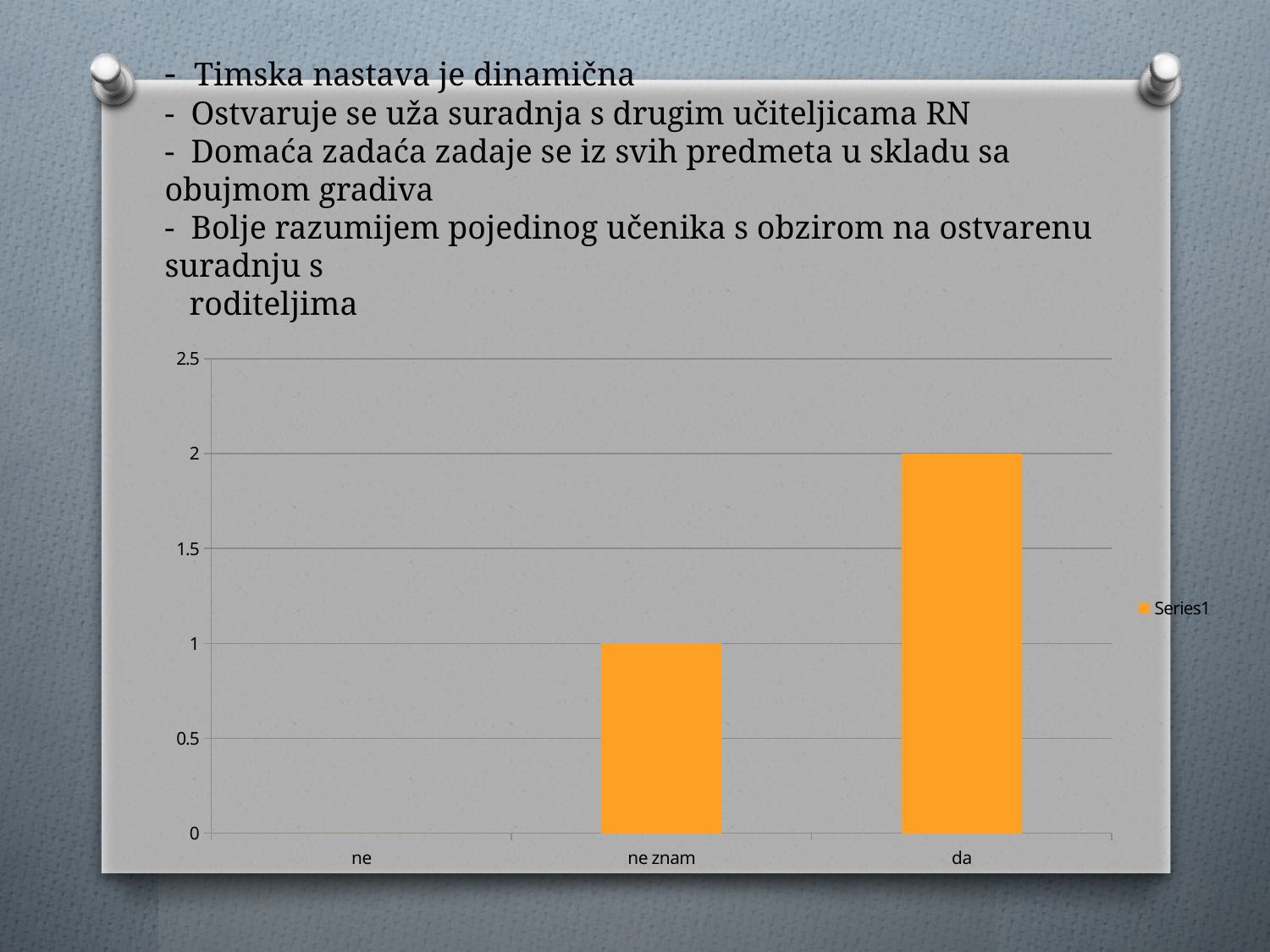
What is the value for "ne znam" in the chart? 1 Which is larger, the value for "da" or the value for "ne znam"? da What kind of chart is shown on the slide? bar chart Which category has the highest value in the chart? da How many categories are shown on the x axis of the chart? 3 What is the value for "da" in the chart? 2 Do the values rise or fall from left to right along the x axis? rise What is the value for "ne" in the chart? 0 What is the difference between the values for "da" and "ne znam"? 1 Is the value for "da" greater or less than 1.5? greater How many series does the chart legend list? 1 Which category has the lowest value in the chart? ne